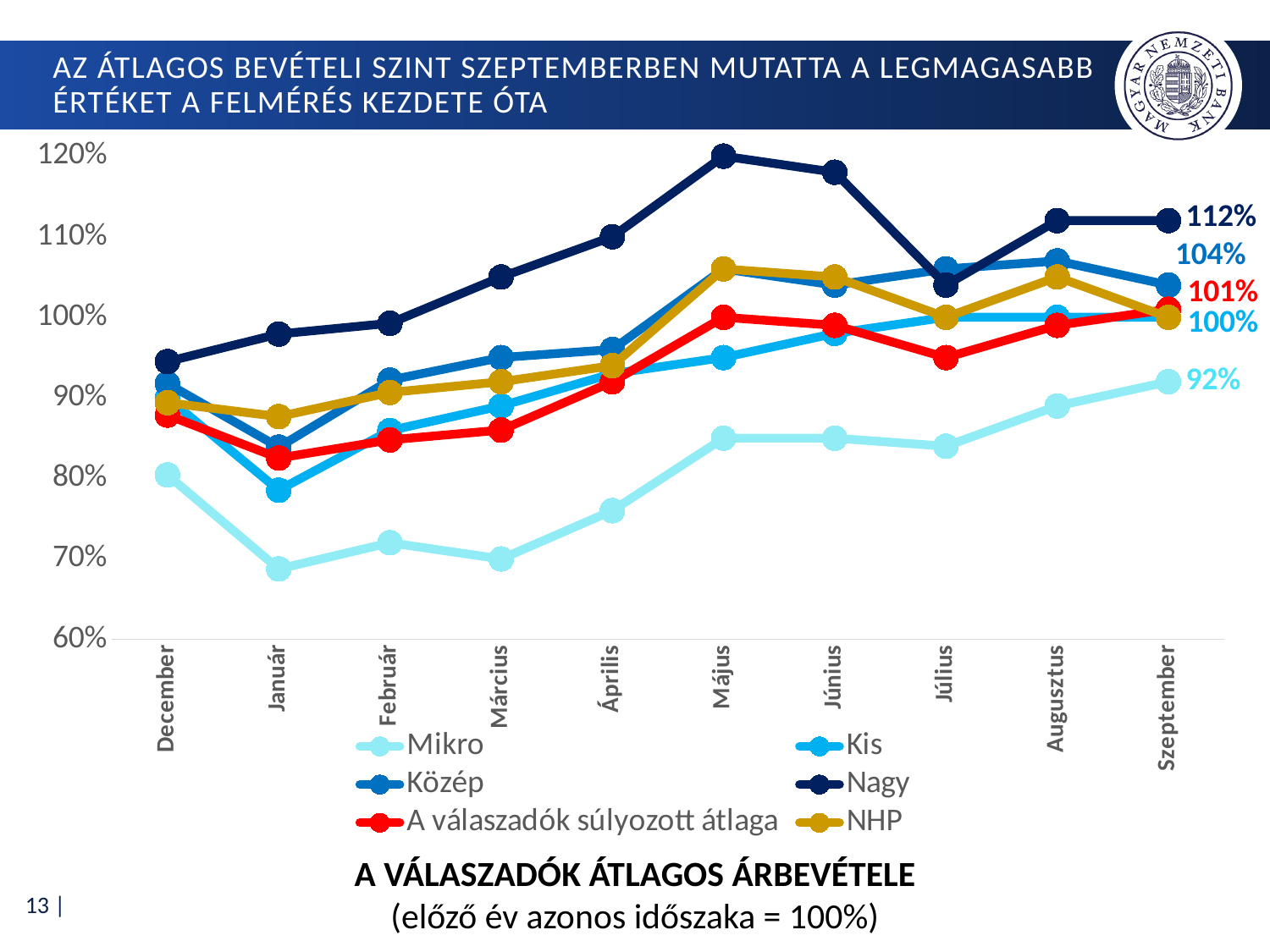
What is the value for Mikro in Szeptember? 92% Which series has the lowest value in Szeptember? Mikro Is the value for Mikro in Január greater or less than 70%? less How many months are shown on the x axis? 10 What is the value for Nagy in Szeptember? 112% What is the difference between the Nagy and Mikro values in Szeptember? 20 percentage points What kind of chart is shown on the slide? line chart How many series does the legend list? 6 Which series has the highest value in Szeptember? Nagy What is the value for A válaszadók súlyozott átlaga in Szeptember? 101% Is the value for Nagy in Május greater or less than 110%? greater What is the value for Közép in Szeptember? 104%